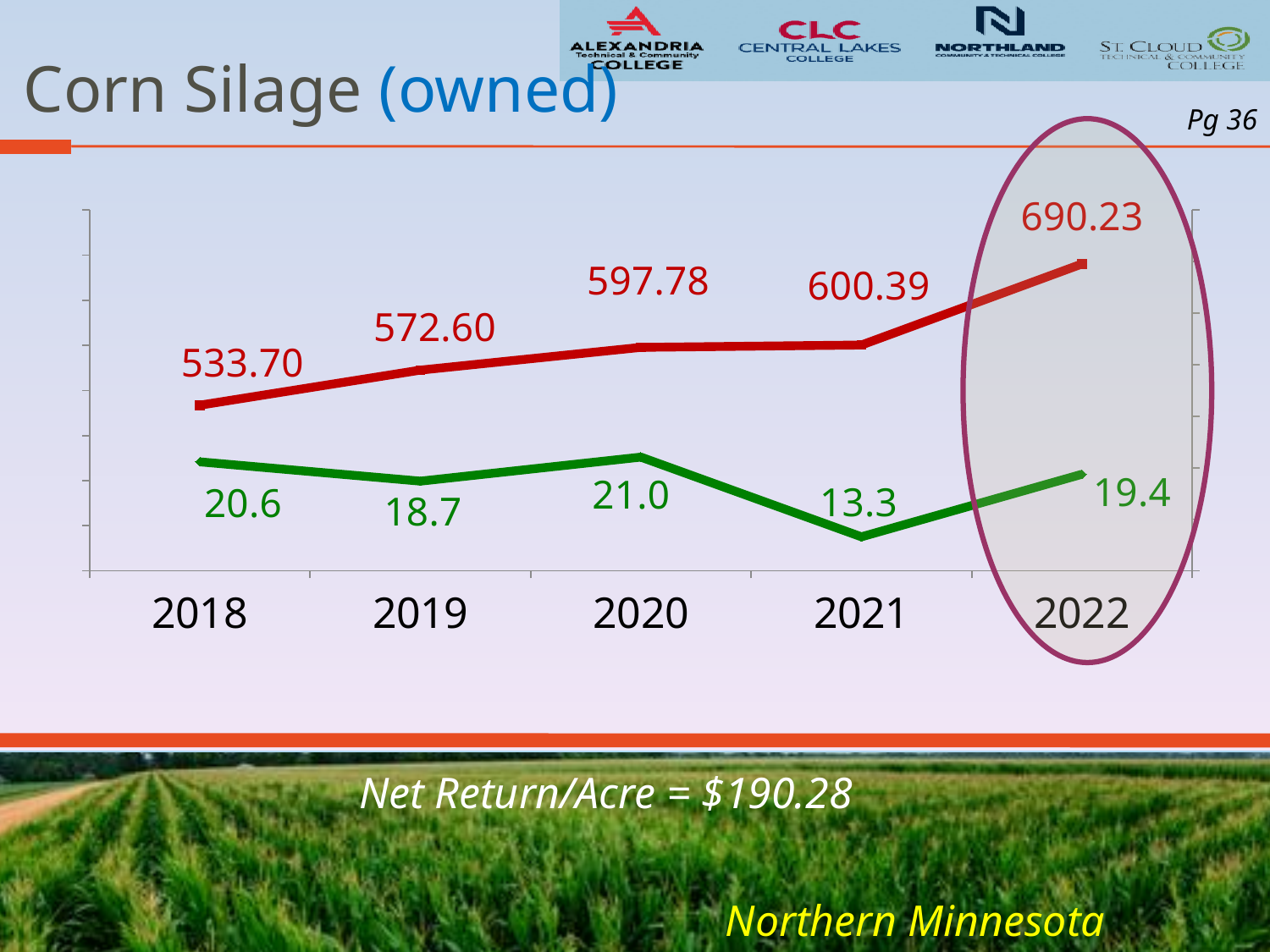
In which year does the green line reach its lowest value? 2021 In which year does the red line reach its highest value? 2022 How many years are shown on the x axis? 5 What is the difference between the red line's values in 2022 and 2021? 89.84 What is the difference between the green line's values in 2020 and 2021? 7.7 Which is larger for the red line: the 2019 value or the 2020 value? 2020 What is the value of the green line in 2019? 18.7 What is the value of the red line in 2018? 533.70 In which year does the green line reach its highest value? 2020 What kind of chart is shown on the slide? Line chart What is the value of the green line in 2021? 13.3 What is the value of the red line in 2022? 690.23